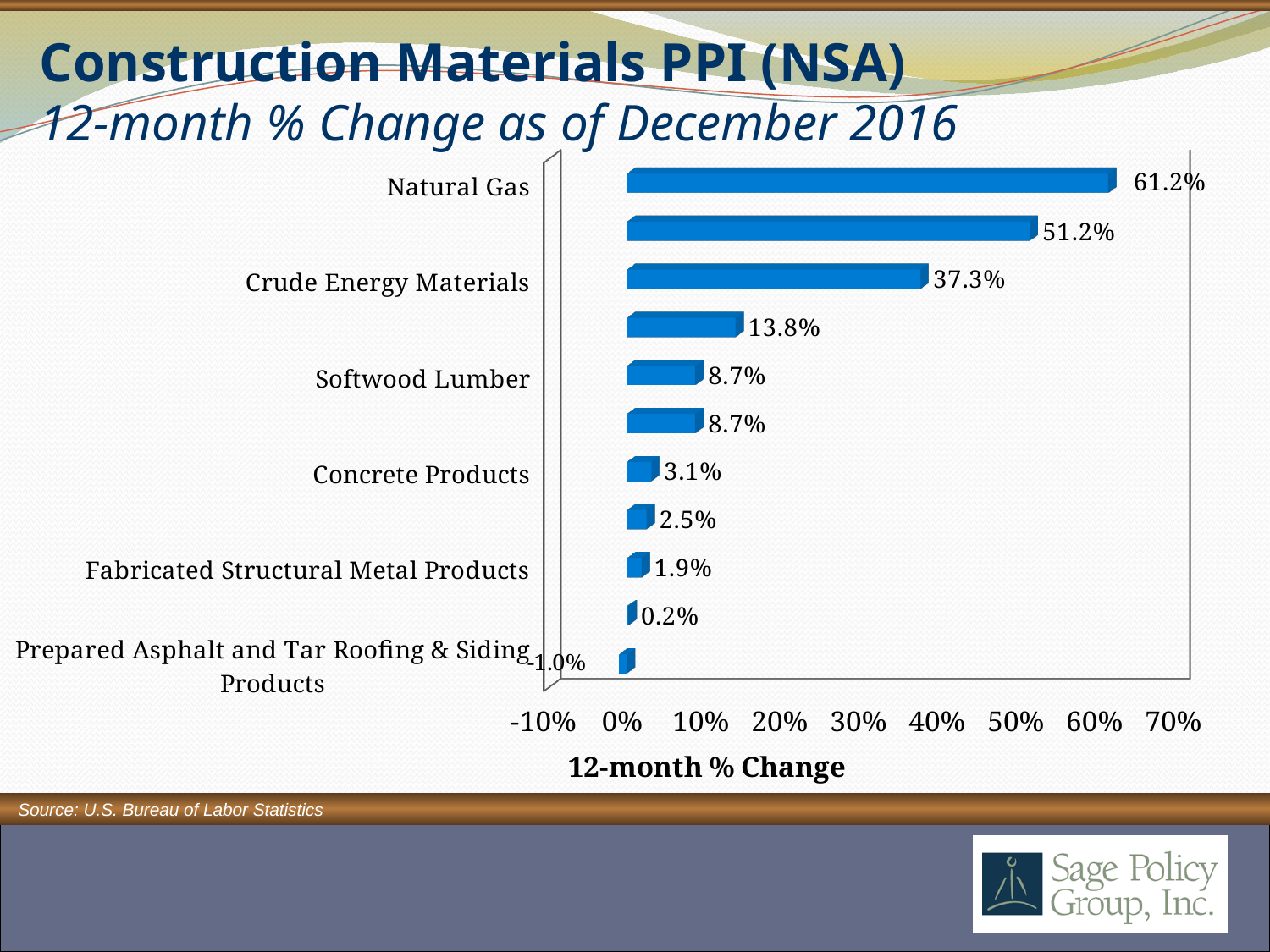
What is the 12-month % change for Prepared Asphalt and Tar Roofing & Siding Products? -1.0% What is the 12-month % change for Softwood Lumber? 8.7% How many bars are plotted in the chart? 11 What is the 12-month % change for Concrete Products? 3.1% Which category has the highest 12-month % change? Natural Gas Which category has the lowest 12-month % change? Prepared Asphalt and Tar Roofing & Siding Products What is the 12-month % change for Natural Gas? 61.2% What is the 12-month % change for Fabricated Structural Metal Products? 1.9% Which has a larger 12-month % change, Softwood Lumber or Concrete Products? Softwood Lumber What kind of chart is shown on the slide? Bar chart What is the difference between the 12-month % change for Natural Gas and Crude Energy Materials? 23.9% What is the 12-month % change for Crude Energy Materials? 37.3%